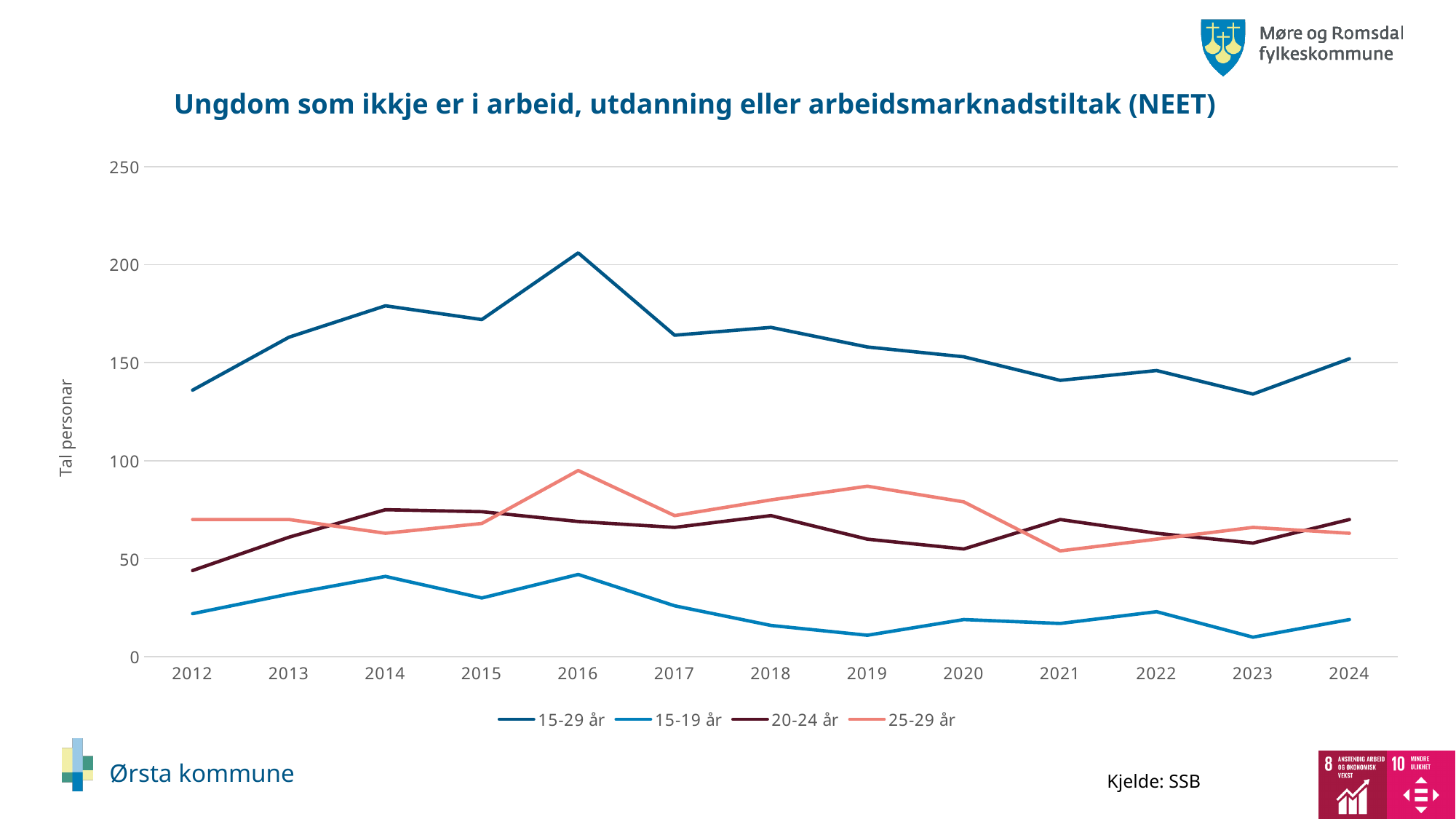
What is the label on the y axis? Tal personar In 2021, which series has the larger value: 20-24 år or 25-29 år? 20-24 år In which year does the 20-24 år series have its lowest value? 2012 Is the value for 20-24 år in 2012 greater or less than 50? less Does the 15-29 år series rise or fall between 2016 and 2023? fall Is the value for 15-29 år in 2012 greater or less than 150? less How many years are plotted along the x axis? 13 Is the value for 15-29 år in 2016 greater or less than 200? greater How many series does the legend list? 4 In which year does the 15-29 år series reach its highest value? 2016 In which year does the 25-29 år series reach its highest value? 2016 What kind of chart is shown on the slide? line chart